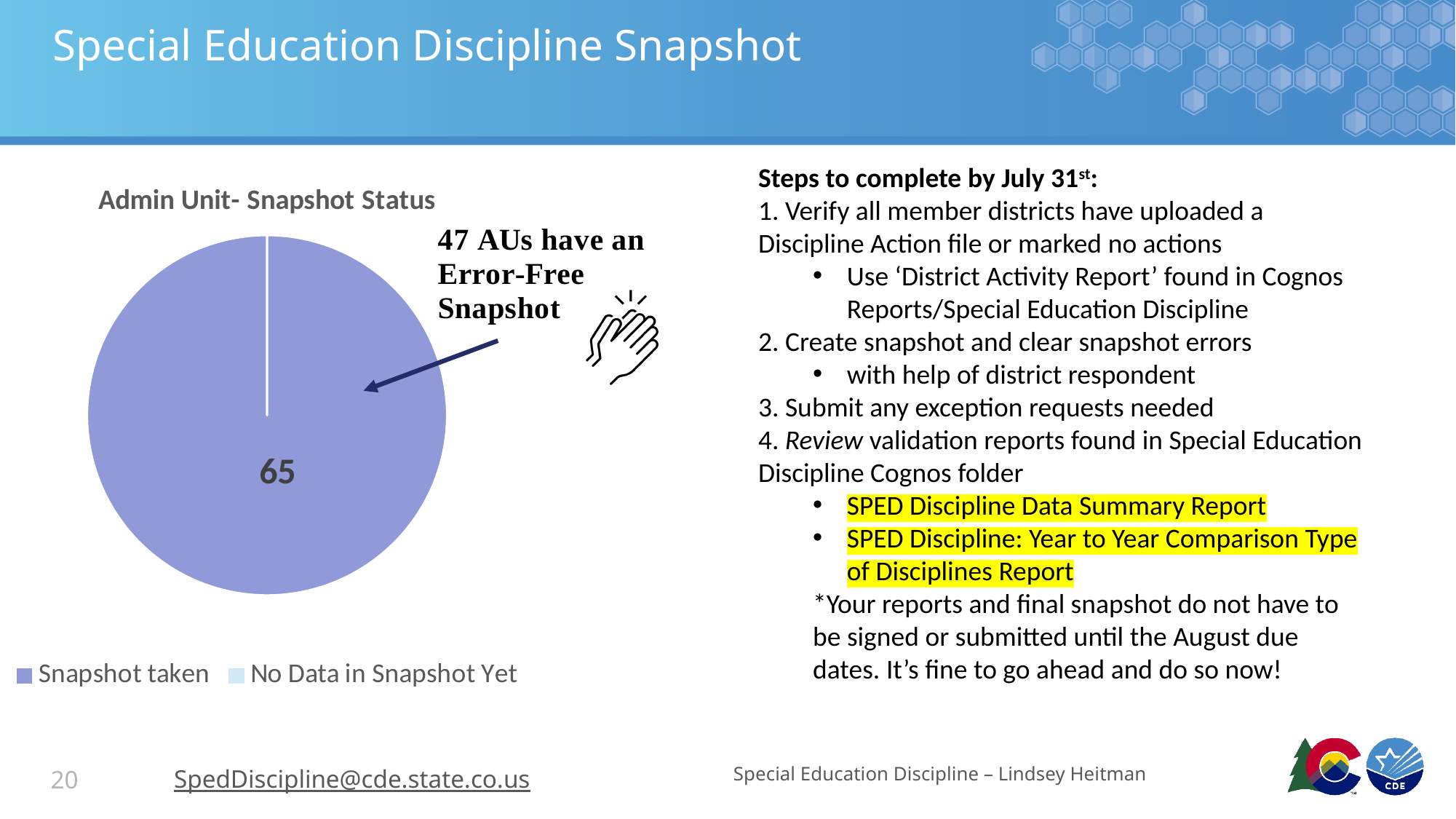
What kind of chart is shown on the slide? pie chart What is the title of the chart? Admin Unit- Snapshot Status Which category has the largest slice of the pie? Snapshot taken Is the value for Snapshot taken greater or less than 50? greater Which is larger, Snapshot taken or No Data in Snapshot Yet? Snapshot taken How many entries does the chart's legend list? 2 Which category has the smallest slice of the pie? No Data in Snapshot Yet According to the annotation next to the chart, how many AUs have an Error-Free Snapshot? 47 What value is shown for the Snapshot taken slice? 65